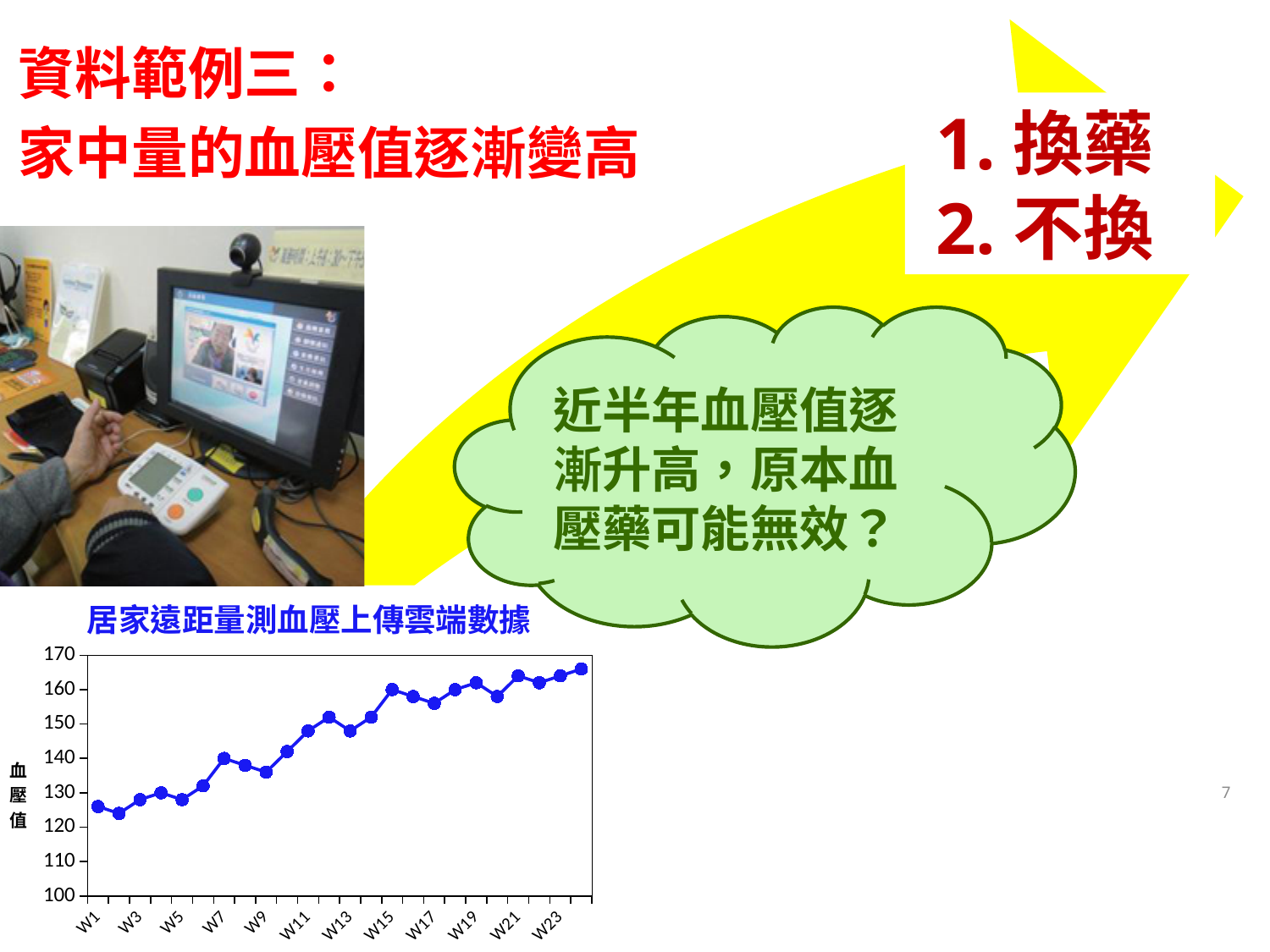
Which has the larger value, W1 or W24? W24 What kind of chart is shown on the slide? line chart Is the value for W12 greater or less than 140? greater Is the value for W24 greater or less than 160? greater Which has the larger value, W9 or W15? W15 Do the blood pressure values generally rise or fall from W1 to W24? rise What is the label on the y axis of the chart? 血壓值 How many weekly data points are plotted on the chart? 24 Is the value for W1 greater or less than 130? less What is the title of the chart on the slide? 居家遠距量測血壓上傳雲端數據